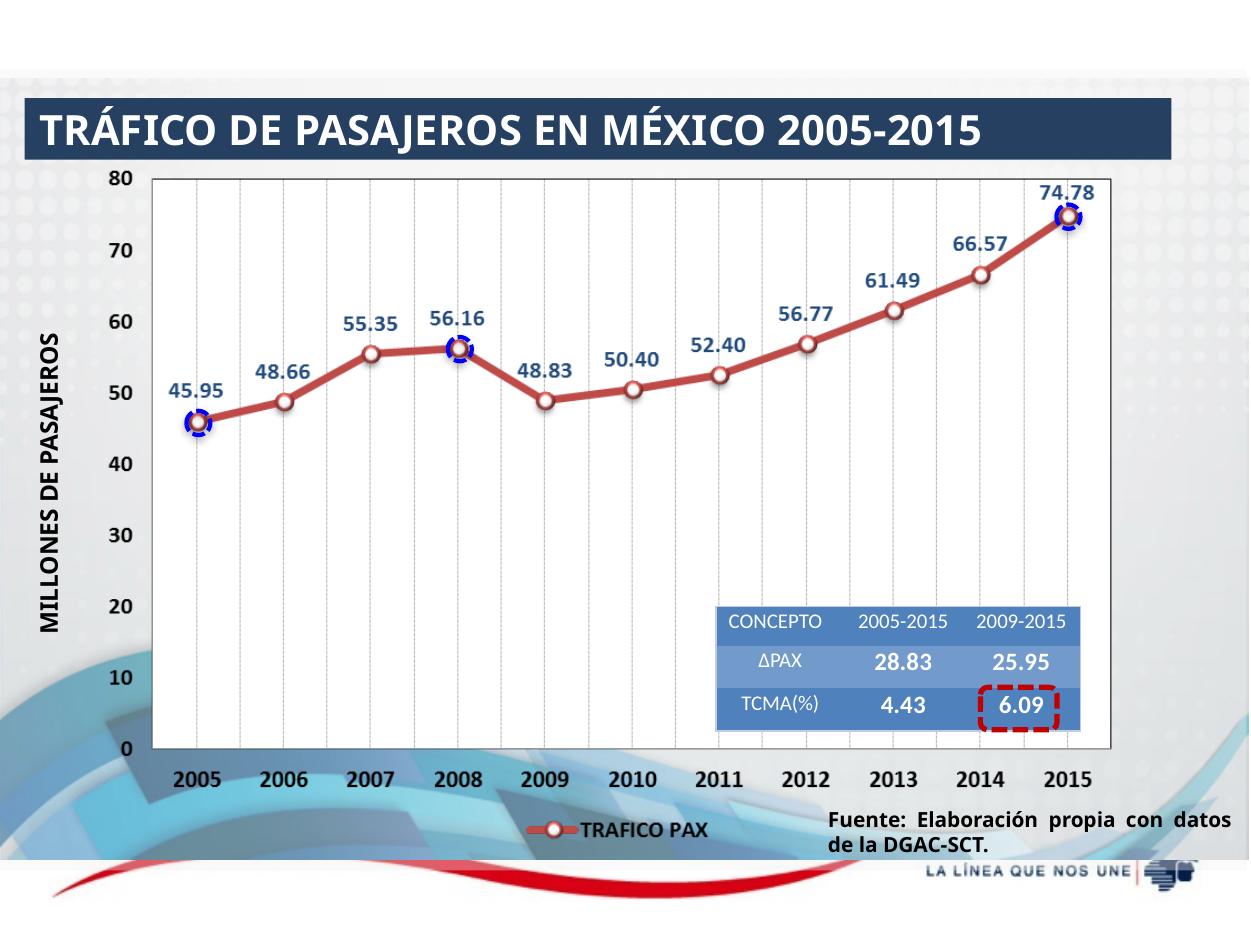
Which year has the lowest value? 2005 What is the value for 2015? 74.78 What is the difference between the values for 2008 and 2009? 7.33 What is the name of the series shown in the legend? TRAFICO PAX What is the value for 2005? 45.95 Is the value for 2013 greater or less than 60? greater Which is larger, the value for 2007 or the value for 2012? 2012 What kind of chart is shown? line chart What is the difference between the values for 2015 and 2005? 28.83 Which year has the highest value? 2015 How many years are plotted on the chart? 11 What is the value for 2009? 48.83